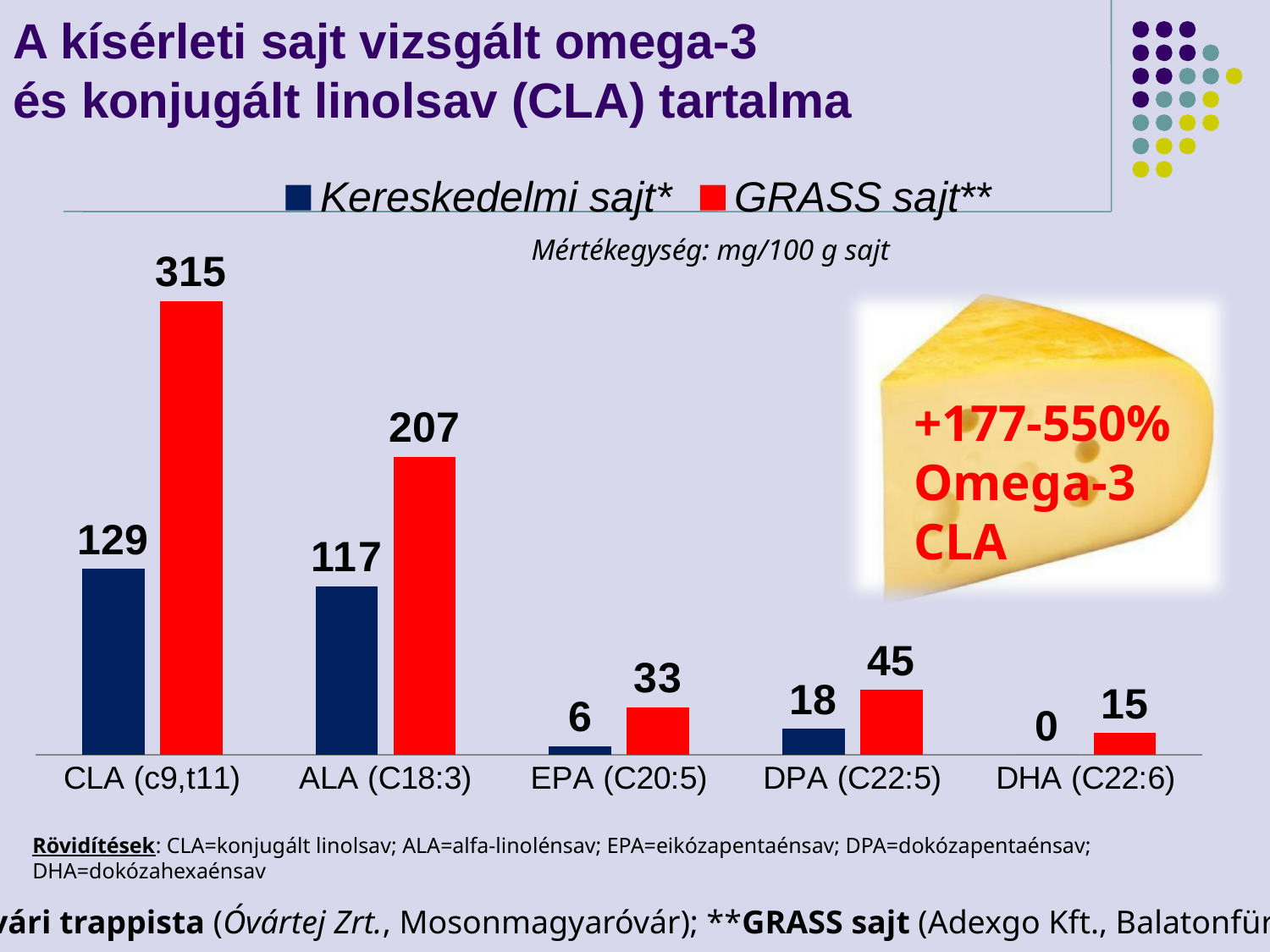
What is the value for Kereskedelmi sajt* in the ALA (C18:3) category? 117 What is the value for GRASS sajt** in the DPA (C22:5) category? 45 What is the difference between the GRASS sajt** and Kereskedelmi sajt* values in the EPA (C20:5) category? 27 How many series does the legend list? 2 What is the value for Kereskedelmi sajt* in the DHA (C22:6) category? 0 Which category has the lowest value for Kereskedelmi sajt*? DHA (C22:6) What is the difference between the GRASS sajt** and Kereskedelmi sajt* values in the CLA (c9,t11) category? 186 What is the value for GRASS sajt** in the CLA (c9,t11) category? 315 What kind of chart is shown on the slide? Bar chart Which is larger in the ALA (C18:3) category: Kereskedelmi sajt* or GRASS sajt**? GRASS sajt** Which category has the highest value for GRASS sajt**? CLA (c9,t11) How many categories are shown on the x axis? 5